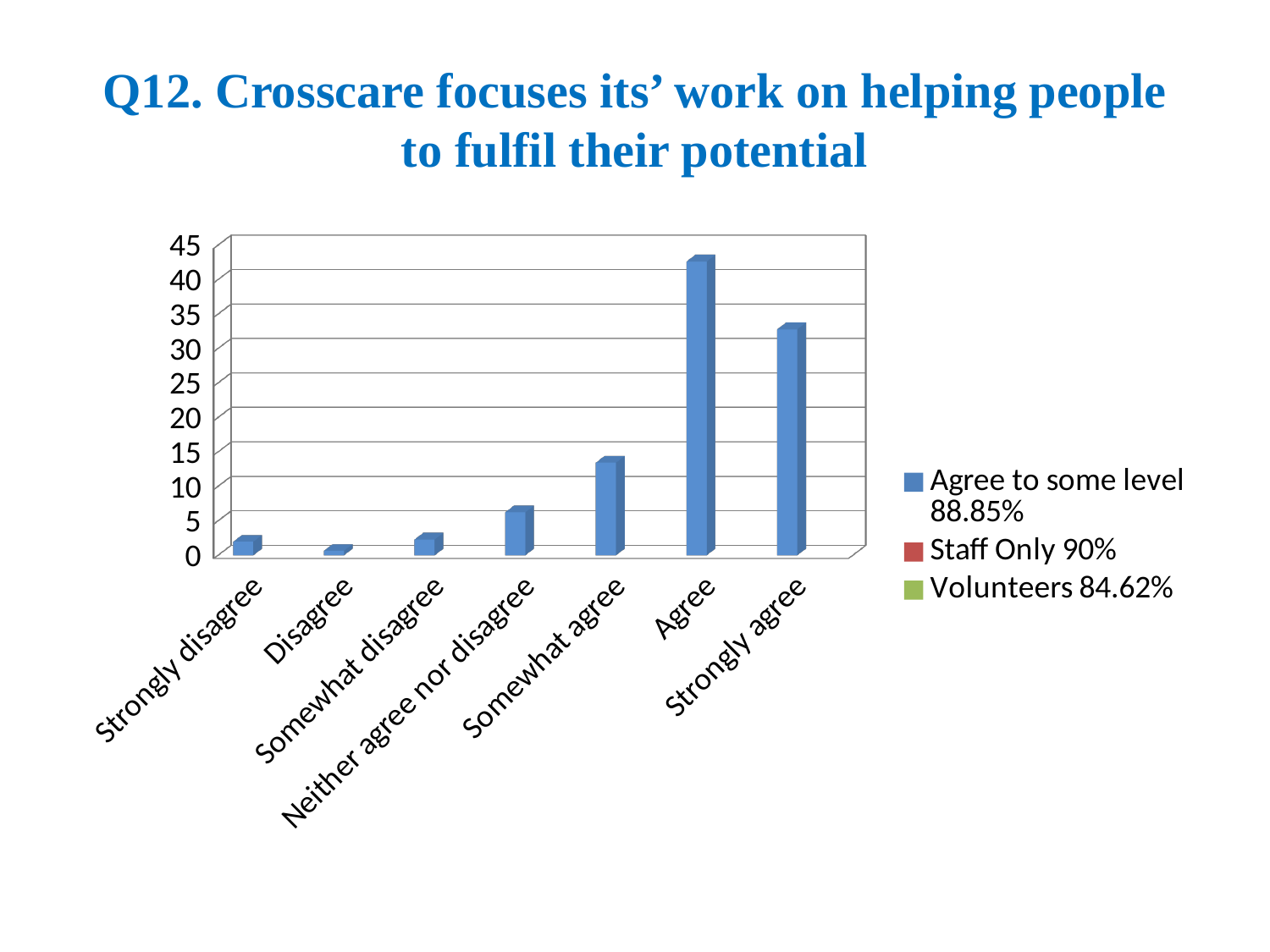
Is the value for Somewhat agree greater or less than 10? greater Is the value for Strongly agree greater or less than 30? greater What percentage does the legend give for Volunteers? 84.62% Is the value for Agree greater or less than 40? greater How many categories are shown on the x axis? 7 Which is larger, the value for Agree or the value for Strongly agree? Agree Which is larger, the value for Somewhat agree or the value for Neither agree nor disagree? Somewhat agree How many entries does the legend list? 3 What kind of chart is shown on the slide? Bar chart Which category has the lowest bar? Disagree Which category has the highest bar? Agree